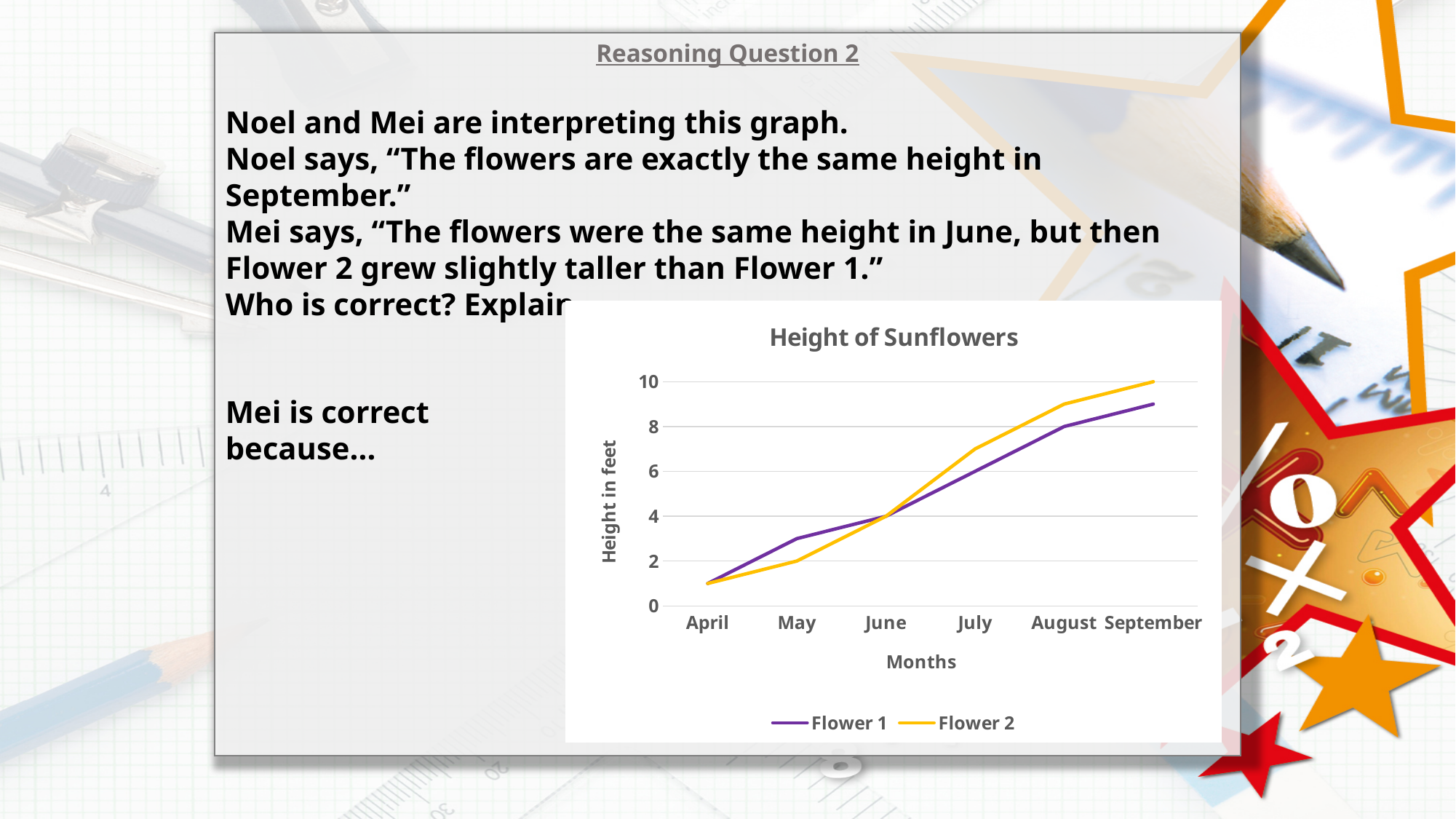
What is the height of Flower 1 in June? 4 Which flower is taller in May, Flower 1 or Flower 2? Flower 1 What is the title of the chart? Height of Sunflowers Do the heights of the flowers rise or fall from April to September? rise Is the height of Flower 2 in August greater or less than 8? greater What is the height of Flower 2 in September? 10 What is the label of the y axis? Height in feet How many months are shown on the x axis? 6 What type of chart is shown on the slide? line chart How many series does the legend list? 2 Which flower is taller in September, Flower 1 or Flower 2? Flower 2